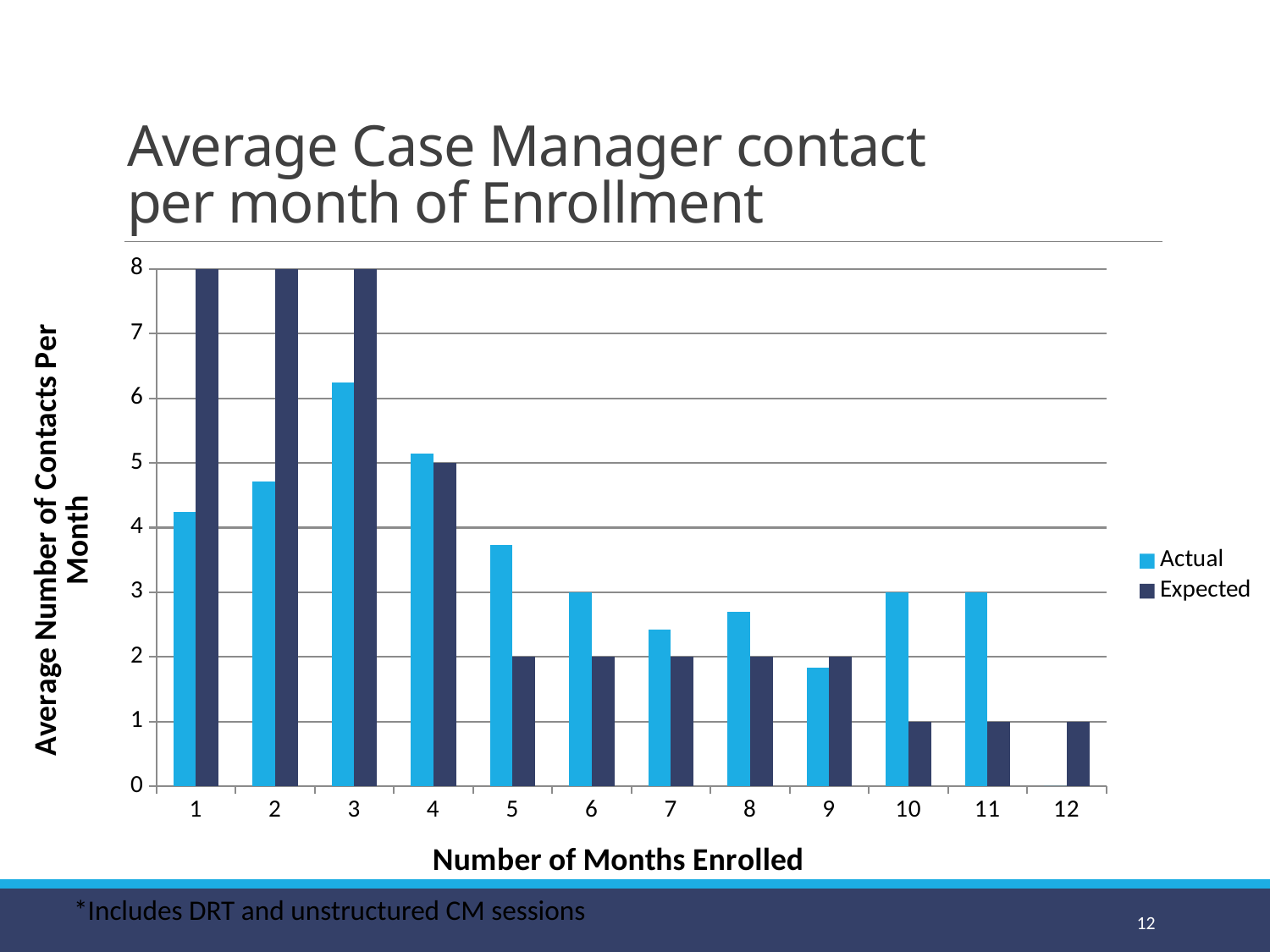
Is the Actual value for month 3 greater or less than 6? greater Is the Actual value for month 9 greater or less than 2? less Which month has the highest Actual value? 3 What is the Expected value for month 4? 5 How many series does the legend list? 2 What is the Expected value for month 12? 1 What is the Actual value for month 10? 3 What is the Expected value for month 1? 8 Which is larger for month 5, the Actual value or the Expected value? Actual What type of chart is shown on the slide? bar chart How many months are shown on the x axis? 12 What is the Expected value for month 7? 2